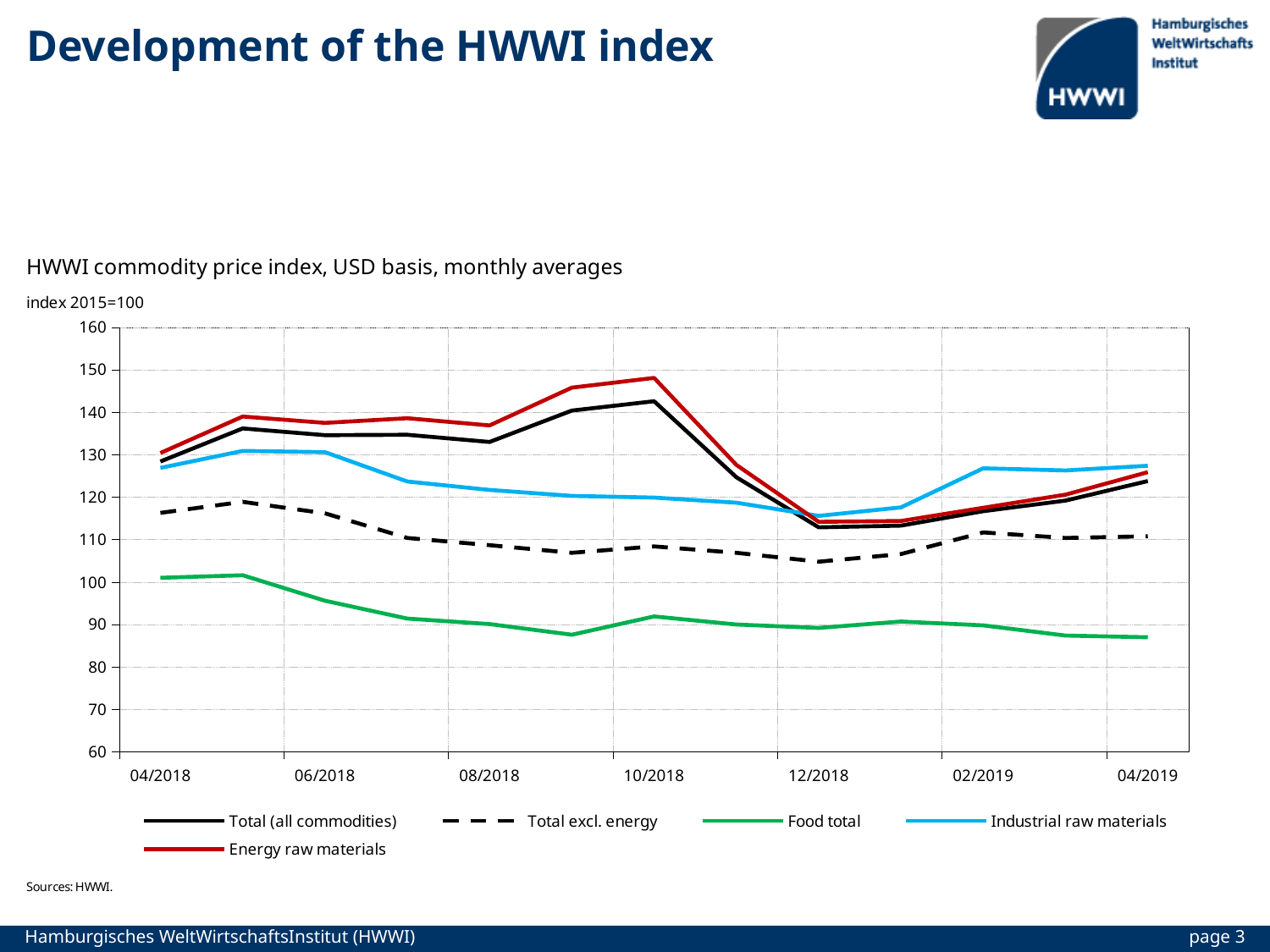
Does the Energy raw materials series rise or fall between 10/2018 and 12/2018? fall What kind of chart is shown on the slide? line chart How many series does the legend list? 5 What is the title of the chart? HWWI commodity price index, USD basis, monthly averages At 04/2019, which is higher: Industrial raw materials or Food total? Industrial raw materials Is the value for Total excl. energy at 12/2018 greater or less than 110? less Which series has the lowest value at 04/2019? Food total Is the value for Food total at 04/2019 greater or less than 90? less What colour is the Food total line? green Is the value for Industrial raw materials at 04/2018 greater or less than 120? greater Which series has the highest value at 10/2018? Energy raw materials